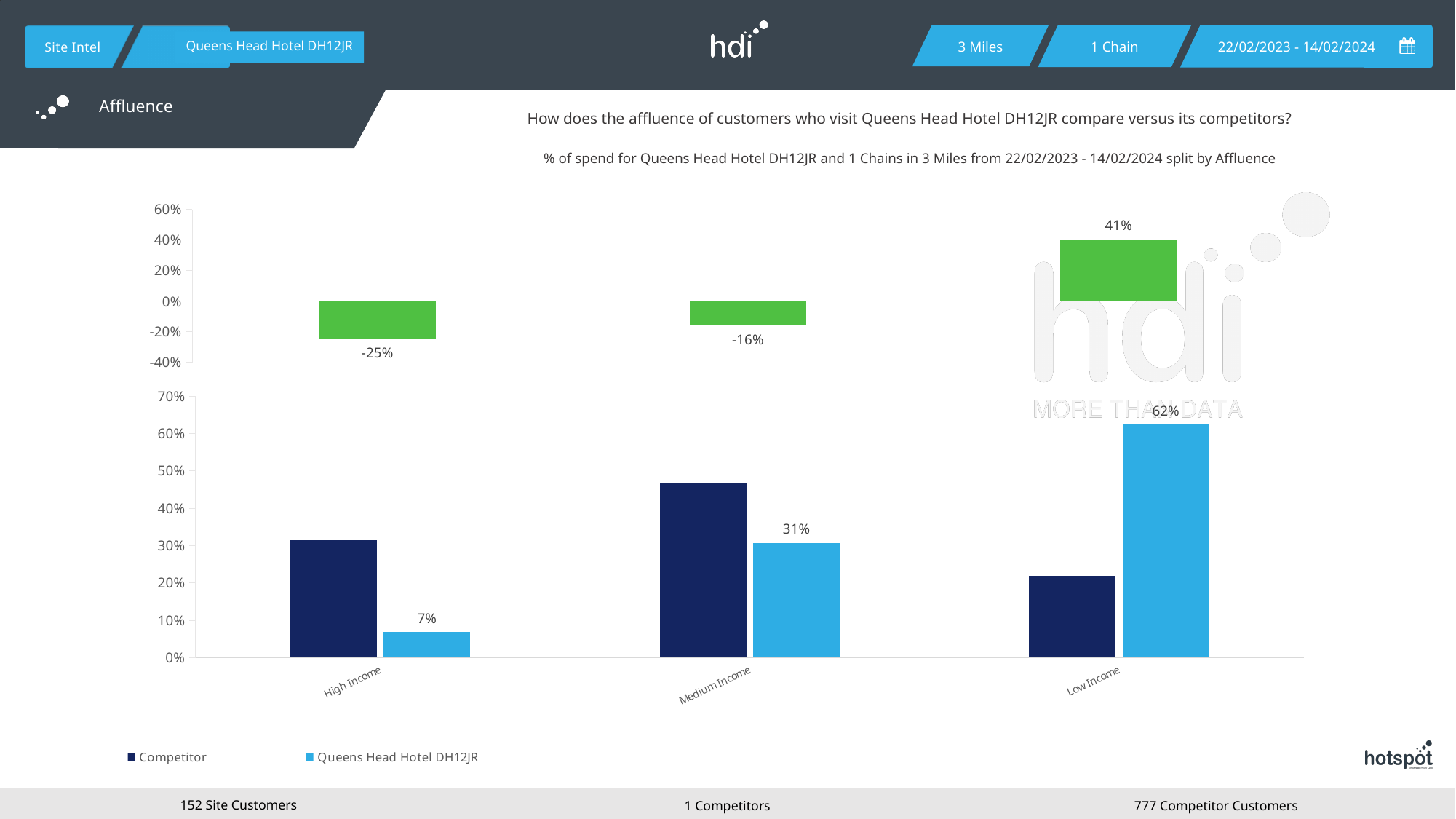
In the top chart, what is the value shown for the Medium Income category? -16% In the top chart, which category has the lowest value? High Income How many series does the legend of the bottom chart list? 2 In the top chart, which category has the highest value? Low Income What type of chart is the bottom chart? Bar chart How many categories are shown on the x axis of the bottom chart? 3 In the bottom chart, what is the value for Queens Head Hotel DH12JR in the High Income category? 7% In the bottom chart, what is the difference between the Queens Head Hotel DH12JR values for Low Income and High Income? 55% In the bottom chart, which is larger for Medium Income: the Competitor bar or the Queens Head Hotel DH12JR bar? Competitor In the bottom chart, is the Competitor value for Medium Income greater or less than 40%? greater In the bottom chart, what is the value for Queens Head Hotel DH12JR in the Low Income category? 62% In the bottom chart, is the Competitor value for Low Income greater or less than 30%? less